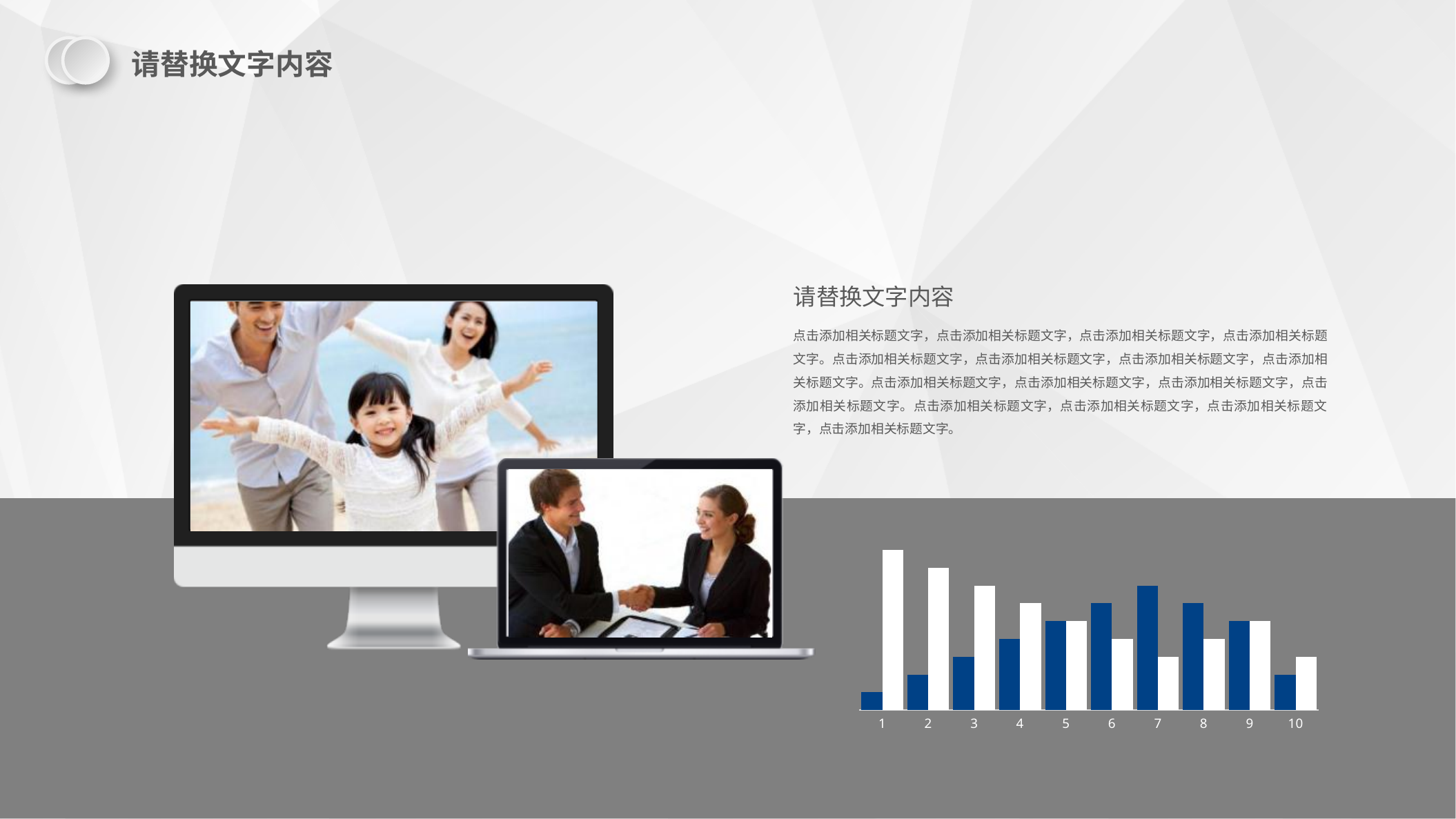
Which category has the shortest blue bar in the bar chart? 1 Which category has the tallest white bar in the bar chart? 1 At category 3, which bar is taller, the blue bar or the white bar? the white bar What kind of chart is shown at the bottom right of the slide? bar chart Do the blue bars rise or fall from category 1 to category 7? rise Which category has the tallest blue bar in the bar chart? 7 How many categories are shown on the x axis of the bar chart? 10 Is the blue bar at category 7 taller or shorter than the blue bar at category 10? taller At category 7, which bar is taller, the blue bar or the white bar? the blue bar Do the white bars rise or fall from category 1 to category 7? fall How many bar series (colours) are plotted in the bar chart? 2